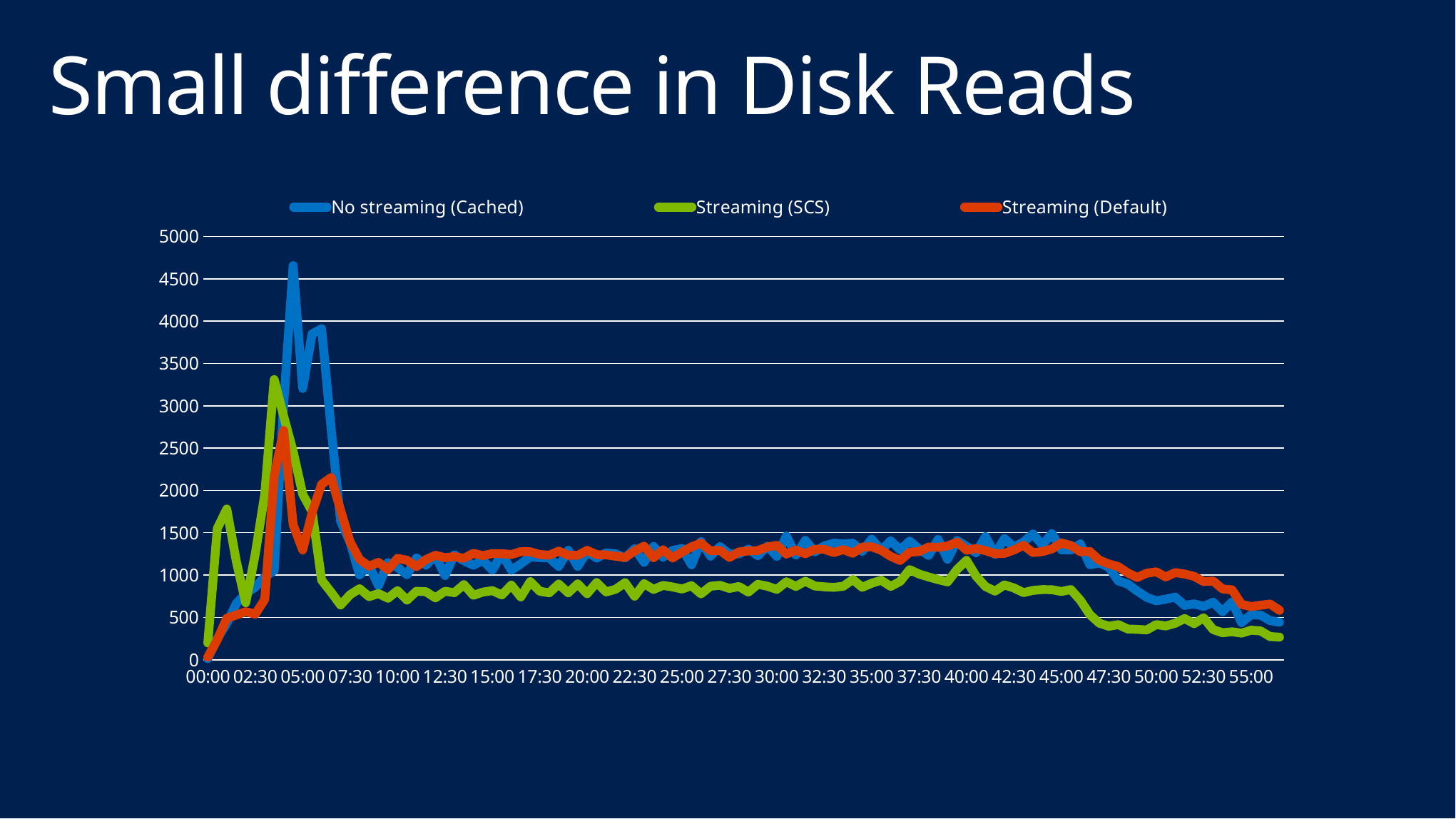
Is the peak value of the No streaming (Cached) series greater or less than 4000? greater Is the peak value of the Streaming (Default) series greater or less than 3000? less Do the values of all three series rise or fall between 45:00 and 55:00? fall What kind of chart is shown on the slide? line chart Is the peak value of the Streaming (SCS) series greater or less than 3000? greater Which series reaches the highest peak value on the chart? No streaming (Cached) How many series does the legend list? 3 What is the title of the slide containing the chart? Small difference in Disk Reads At 30:00, is the value for Streaming (Default) larger or smaller than the value for Streaming (SCS)? larger What is the highest value shown on the y axis? 5000 Between 20:00 and 40:00, which series has the lowest values? Streaming (SCS) Which colour is used for the Streaming (SCS) series? green